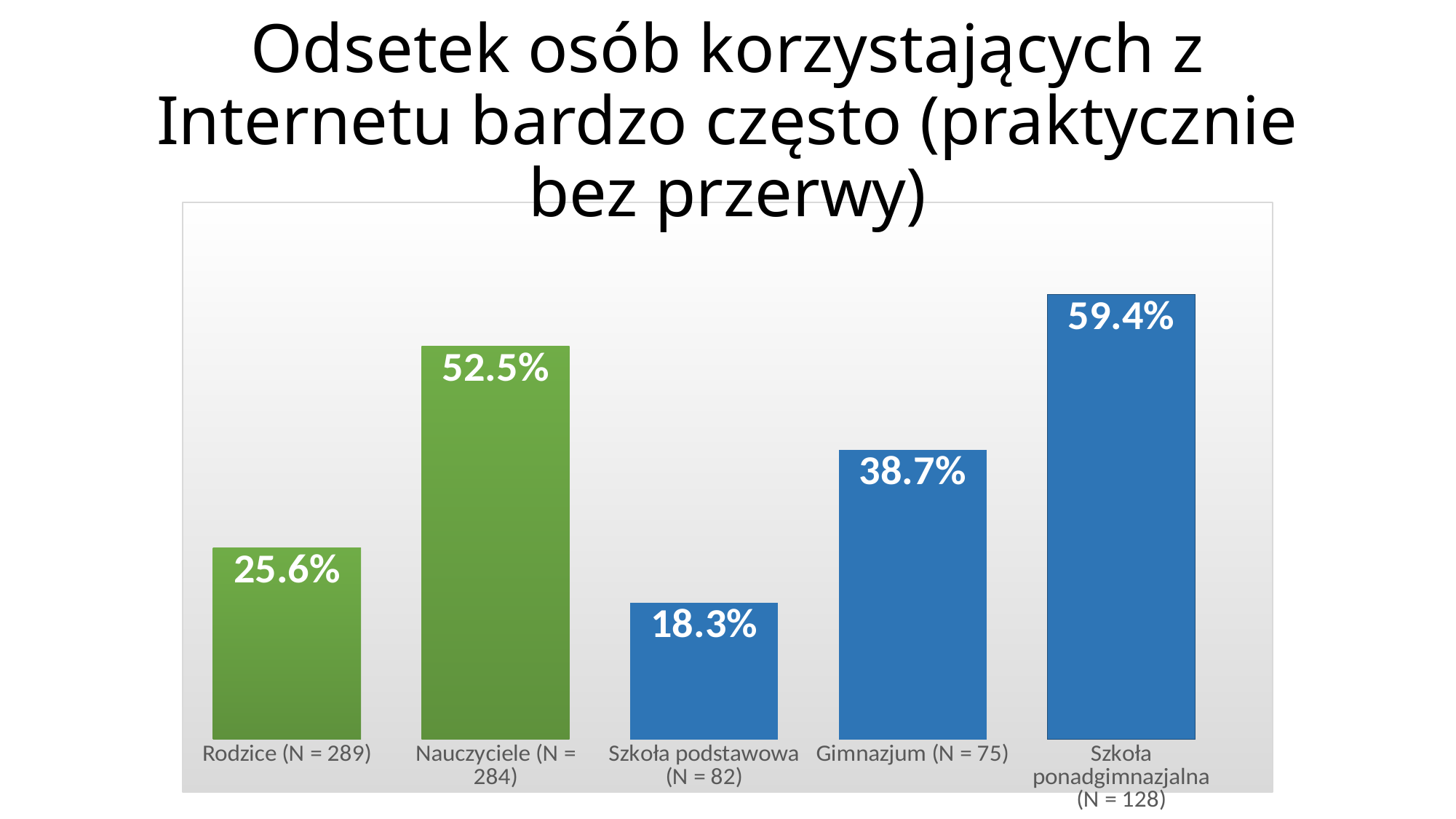
What is the value for Szkoła podstawowa (N = 82)? 18.3% What is the difference between the values for Nauczyciele (N = 284) and Rodzice (N = 289)? 26.9% What kind of chart is shown on the slide? Bar chart What colour are the bars for Rodzice and Nauczyciele? Green Which category has the highest value? Szkoła ponadgimnazjalna (N = 128) Which category has the lowest value? Szkoła podstawowa (N = 82) Which is larger, the value for Gimnazjum (N = 75) or the value for Rodzice (N = 289)? Gimnazjum (N = 75) What is the value for Rodzice (N = 289)? 25.6% What is the value for Gimnazjum (N = 75)? 38.7% What is the value for Nauczyciele (N = 284)? 52.5% What is the value for Szkoła ponadgimnazjalna (N = 128)? 59.4% How many categories are shown in the chart? 5